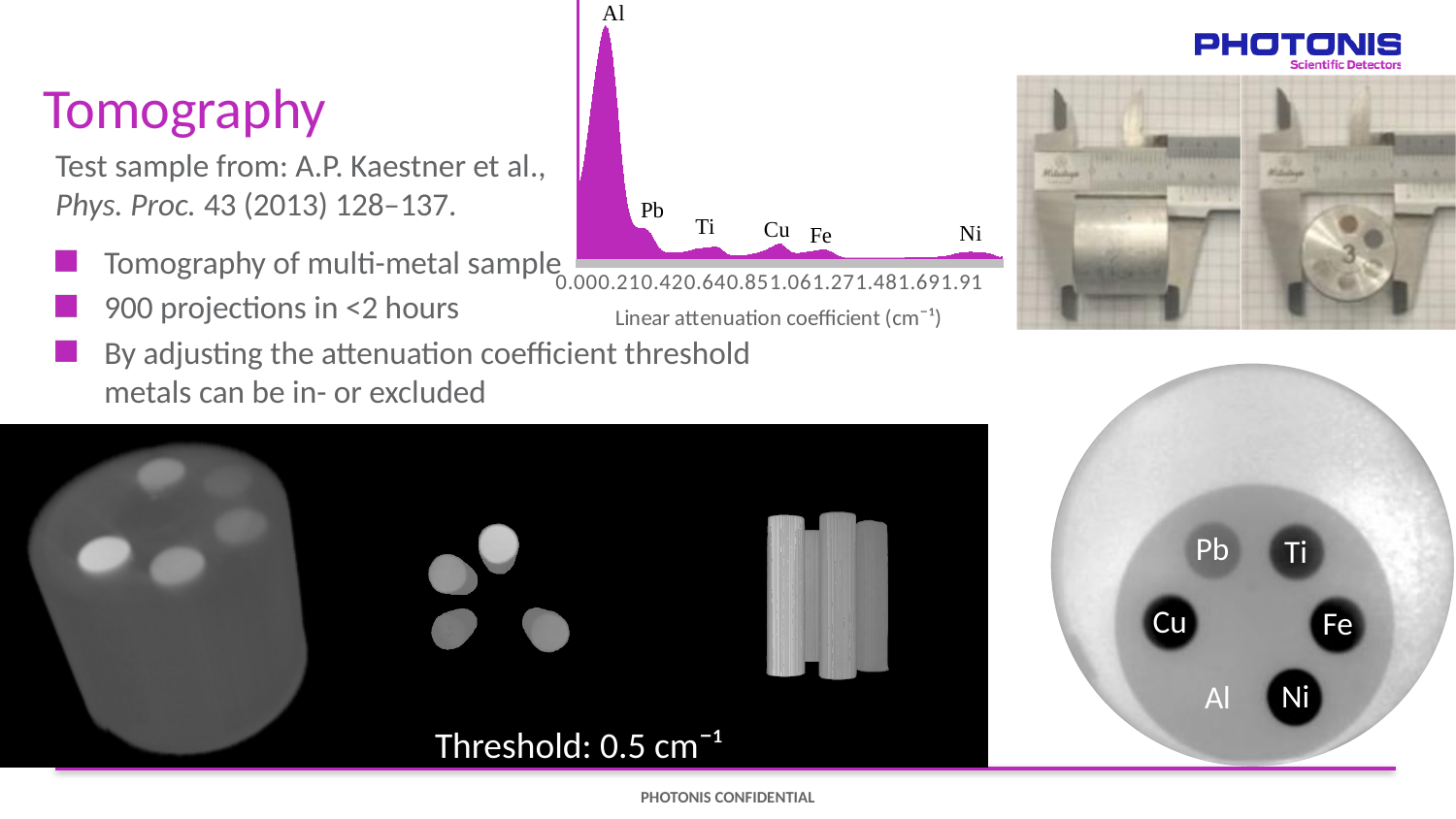
Is the linear attenuation coefficient at the Ni peak greater or less than 1.69? greater Is the linear attenuation coefficient at the Al peak greater or less than 0.21? less What kind of chart is shown at the top centre of the slide? area chart Which labelled metal has the tallest peak in the attenuation chart? Al Is the linear attenuation coefficient at the Fe peak greater or less than 0.85? greater Which labelled metal peak lies at the highest linear attenuation coefficient in the chart? Ni Which labelled peak in the attenuation chart is located between the Pb and Cu peaks? Ti Which labelled metal peak lies at the lowest linear attenuation coefficient in the chart? Al What is the title of the x axis of the attenuation chart? Linear attenuation coefficient (cm⁻¹) How many metals are labelled on the peaks of the attenuation chart? 6 In the attenuation chart, is the Al peak taller or the Pb peak? Al What is the largest tick value shown on the x axis of the attenuation chart? 1.91